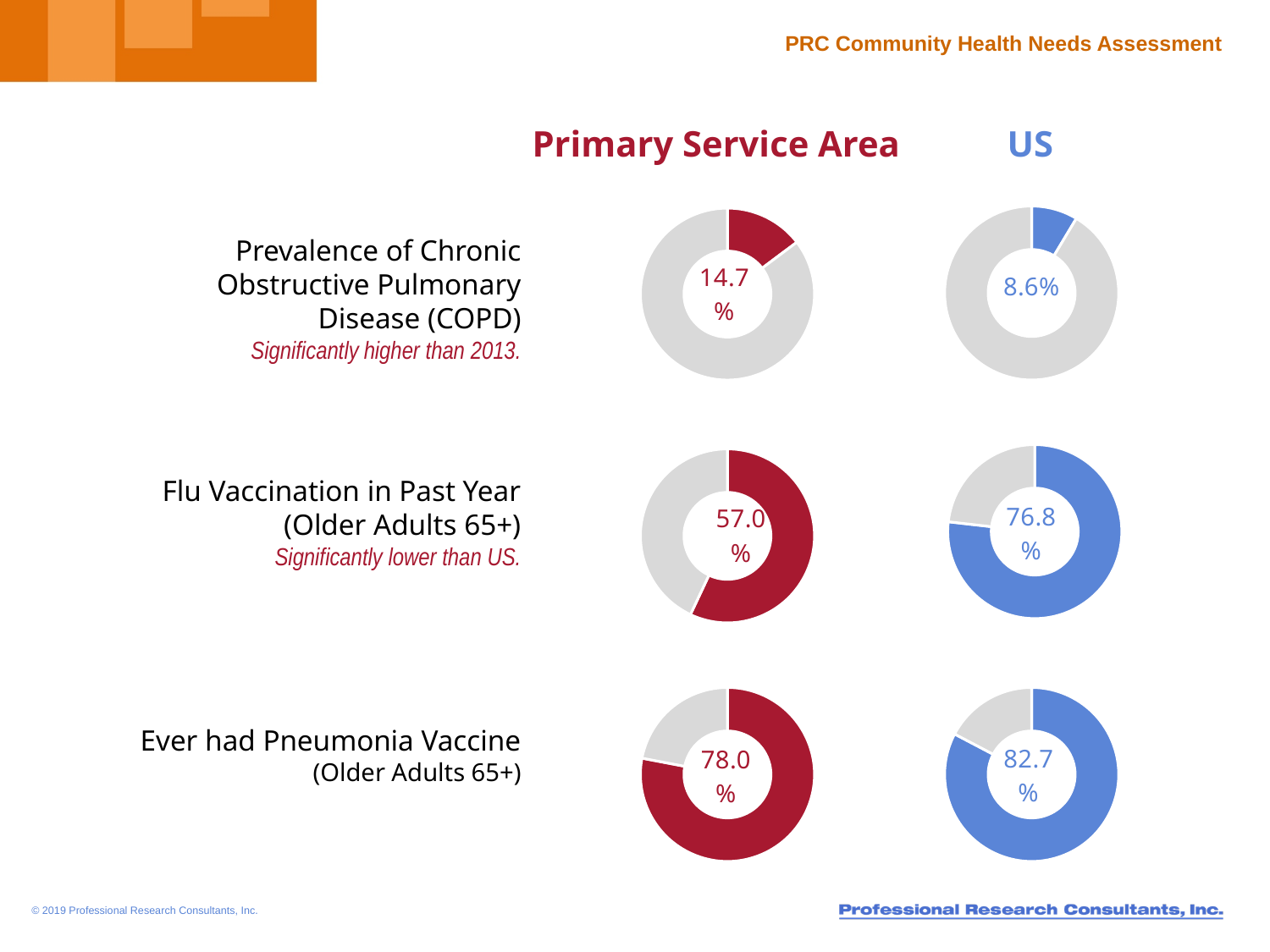
For Flu Vaccination in Past Year (Older Adults 65+), which is larger: the Primary Service Area value or the US value? US What is the US value shown in the donut chart for Flu Vaccination in Past Year (Older Adults 65+)? 76.8% What is the US value shown in the donut chart for Ever had Pneumonia Vaccine (Older Adults 65+)? 82.7% For Prevalence of COPD, which is larger: the Primary Service Area value or the US value? Primary Service Area What is the difference between the Primary Service Area and US values for Prevalence of COPD? 6.1% What is the Primary Service Area value shown in the donut chart for Ever had Pneumonia Vaccine (Older Adults 65+)? 78.0% What is the Primary Service Area value shown in the donut chart for Flu Vaccination in Past Year (Older Adults 65+)? 57.0% What type of chart is used to display the values on this slide? Donut (pie) chart What is the Primary Service Area value shown in the donut chart for Prevalence of Chronic Obstructive Pulmonary Disease (COPD)? 14.7% Among the three Primary Service Area donut charts, which indicator has the highest value? Ever had Pneumonia Vaccine (Older Adults 65+) What is the difference between the US and Primary Service Area values for Flu Vaccination in Past Year (Older Adults 65+)? 19.8% What is the US value shown in the donut chart for Prevalence of Chronic Obstructive Pulmonary Disease (COPD)? 8.6%